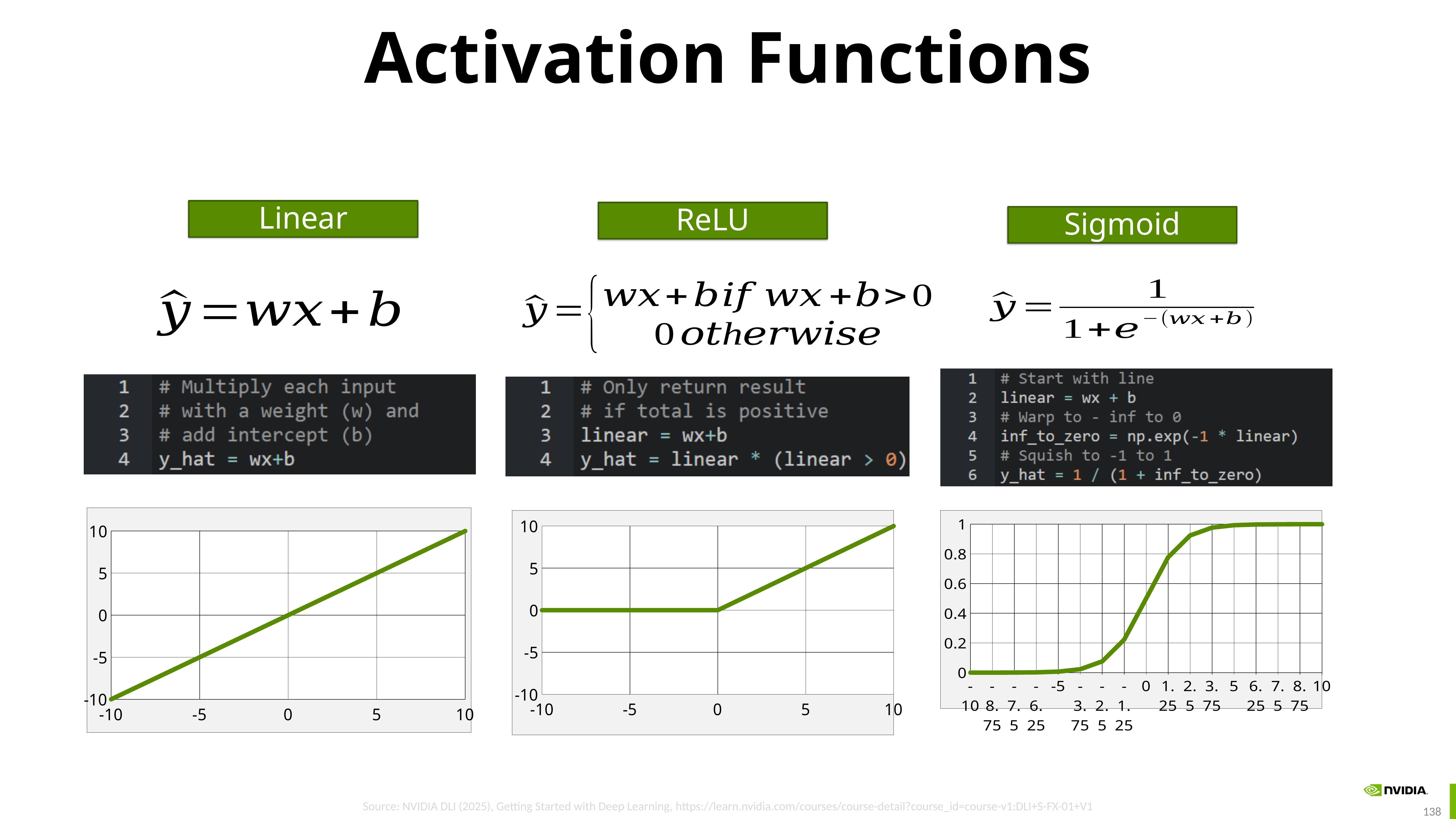
In the Sigmoid chart, is the value of the curve at x = 5 greater or less than 0.8? greater In the ReLU chart, what is the value of the line at x = 10? 10 In the Sigmoid chart, is the value of the curve at x = -5 greater or less than 0.2? less In the ReLU chart, what is the value of the line at x = -5? 0 What kind of chart is shown under the Linear heading? line chart What is the lowest value shown on the y axis of the ReLU chart? -10 In the ReLU chart, what is the value of the line at x = 5? 5 In the Linear chart, what is the value of the line at x = 0? 0 In the Linear chart, what is the value of the line at x = 10? 10 In the Linear chart, do the values rise or fall as x increases? rise In the Linear chart, what is the value of the line at x = -10? -10 How many charts are shown on the slide? 3